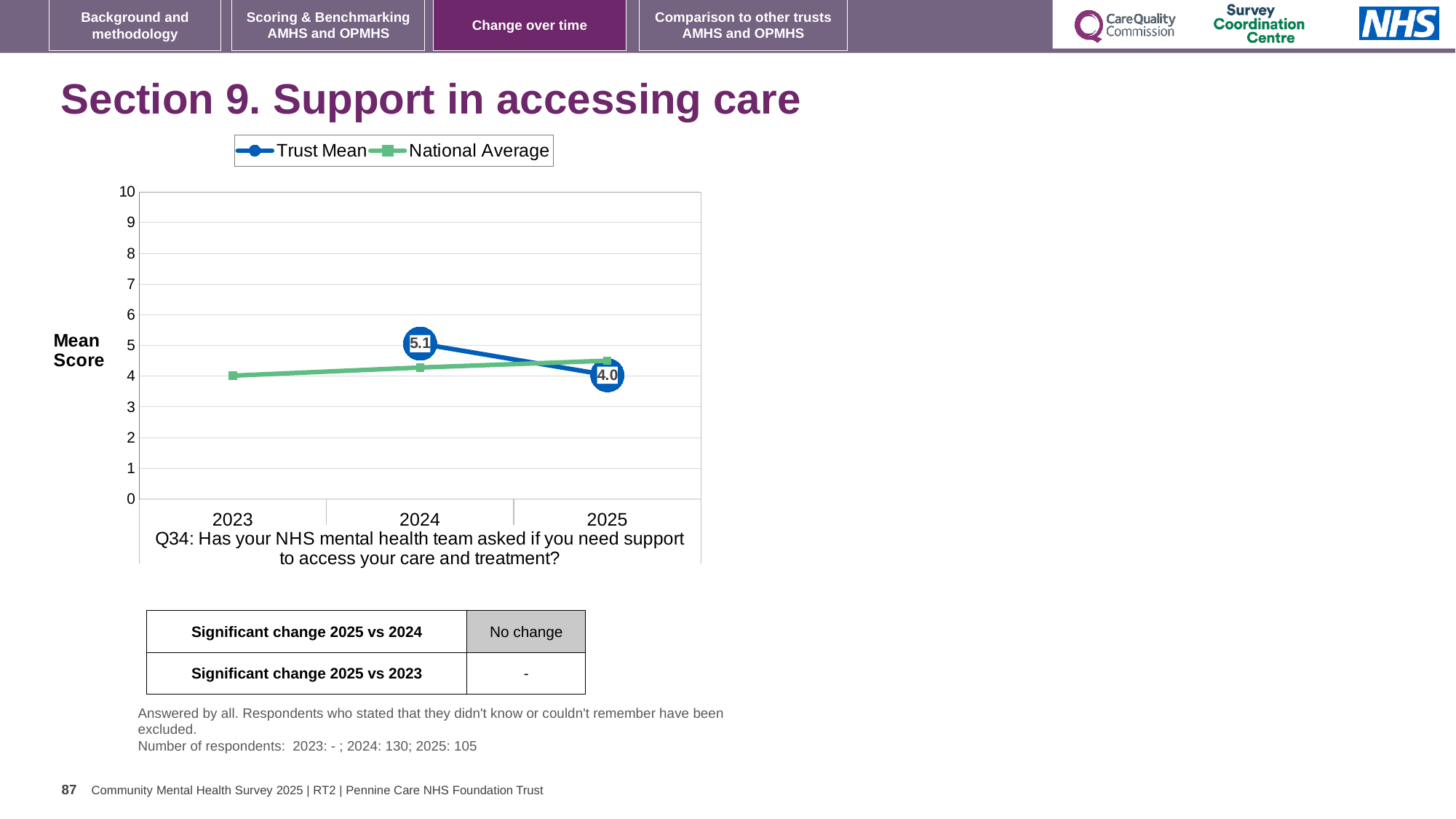
What is the Trust Mean value for 2025? 4.0 How many years are shown on the x axis? 3 What kind of chart is shown on the slide? line chart In 2025, which is higher, the Trust Mean or the National Average? National Average What is the Trust Mean value for 2024? 5.1 Does the National Average rise or fall from 2023 to 2025? rise By how much did the Trust Mean change between 2024 and 2025? 1.1 Is the National Average value for 2023 greater or less than 5? less How many series does the legend list? 2 Does the Trust Mean rise or fall from 2024 to 2025? fall Which year has the higher Trust Mean, 2024 or 2025? 2024 In 2024, which is higher, the Trust Mean or the National Average? Trust Mean